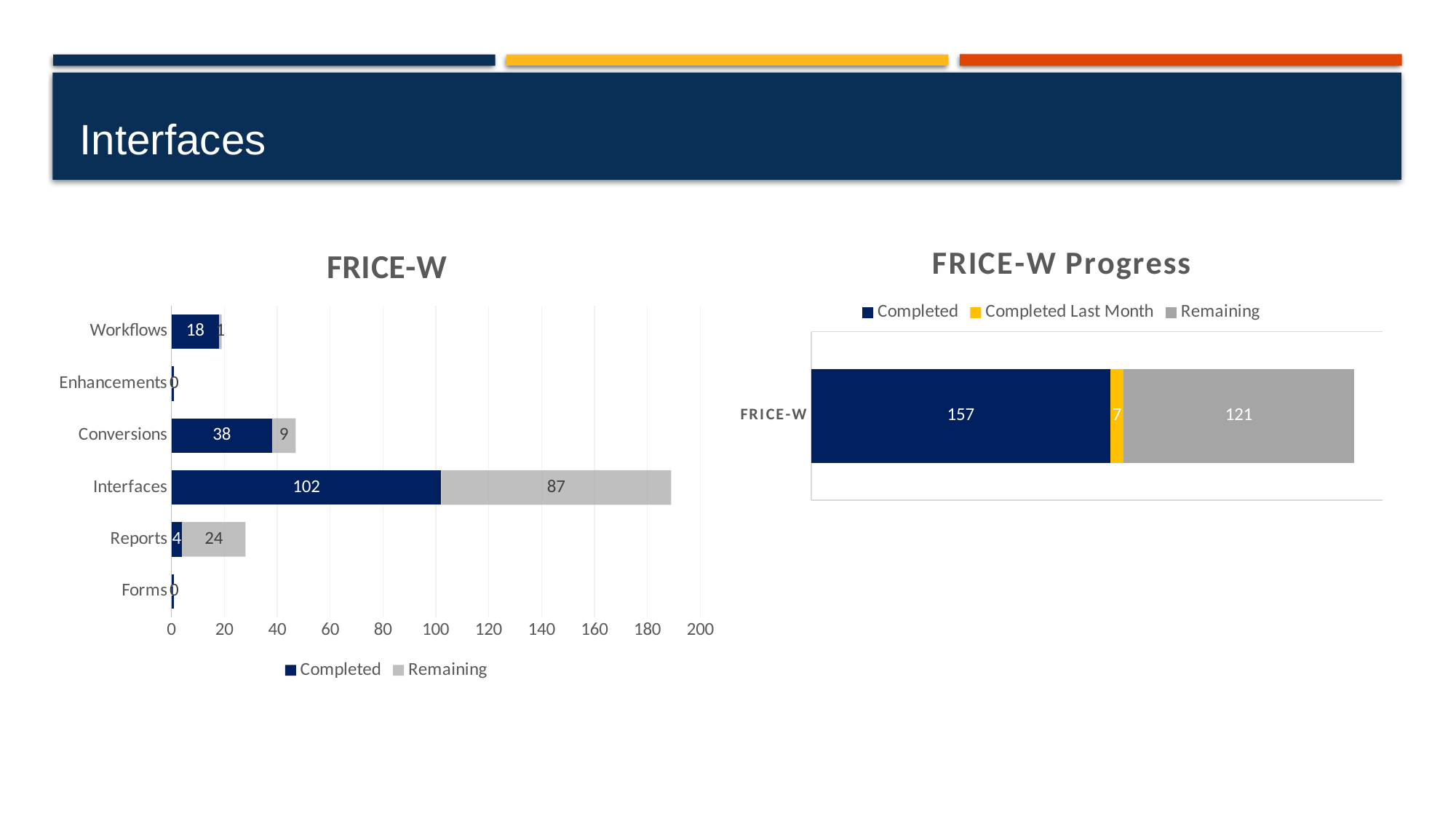
How many categories are shown in the FRICE-W chart? 6 In the FRICE-W chart, what is the difference between the Completed and Remaining values for Interfaces? 15 In the FRICE-W chart, which category has the highest Completed value? Interfaces In the FRICE-W Progress chart, what is the Completed value? 157 In the FRICE-W chart, what is the Completed value for Conversions? 38 In the FRICE-W chart, what is the Completed value for Interfaces? 102 In the FRICE-W chart, what is the Remaining value for Reports? 24 What kind of chart is the FRICE-W Progress chart? Bar chart In the FRICE-W Progress chart, what is the total of the stacked bar? 285 How many series does the legend of the FRICE-W chart list? 2 In the FRICE-W chart, what is the Remaining value for Interfaces? 87 In the FRICE-W Progress chart, what is the Remaining value? 121